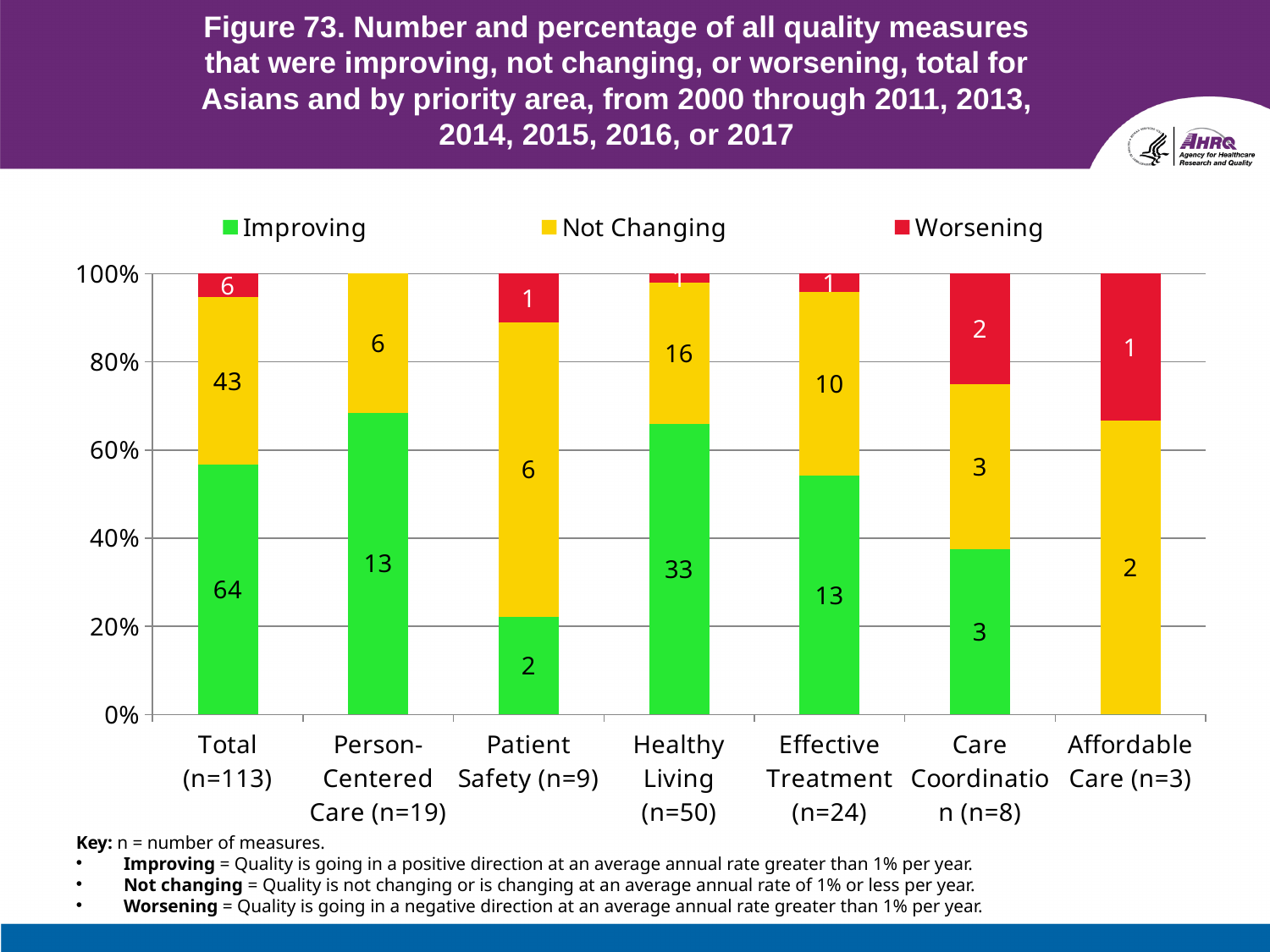
What is the number of Improving measures for Patient Safety (n=9)? 2 What is the number of Not Changing measures for Healthy Living (n=50)? 16 Which is larger for Patient Safety (n=9): the number of Improving measures or the number of Not Changing measures? Not Changing Is the Improving share of the Total (n=113) bar greater or less than 40%? greater What is the number of Worsening measures for Care Coordination (n=8)? 2 How many categories are shown on the x axis? 7 What is the difference between the number of Improving and Not Changing measures for Effective Treatment (n=24)? 3 What kind of chart is shown on the slide? Stacked bar chart How many series does the legend list? 3 Which priority area (excluding Total) has the highest number of Improving measures? Healthy Living (n=50) What is the number of Improving measures for Total (n=113)? 64 What is the total number of measures in the Total (n=113) bar, summing Improving, Not Changing, and Worsening? 113